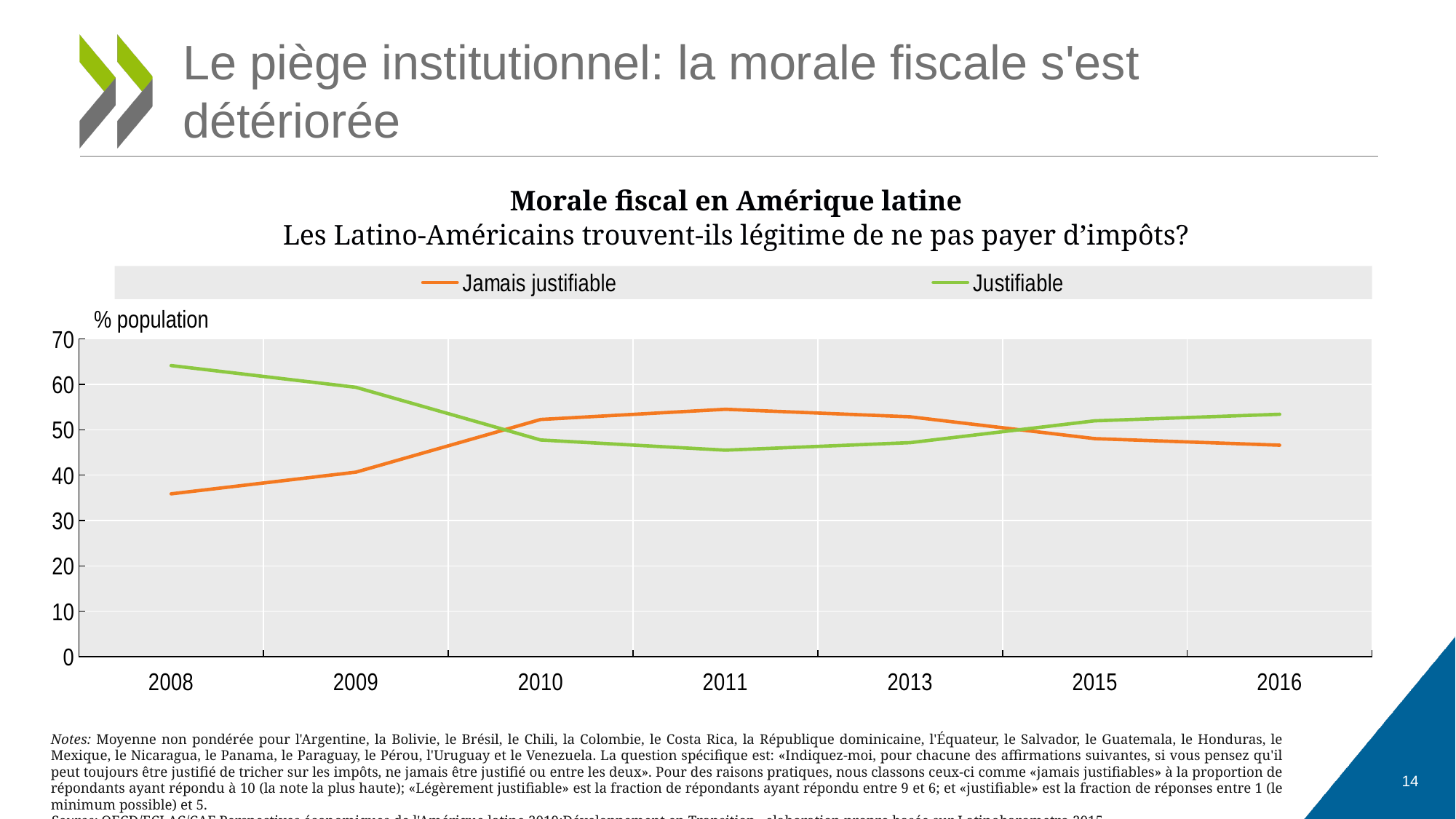
Is the value for Justifiable in 2011 greater or less than 50? less How many years are shown on the x axis? 7 How many series does the legend list? 2 In which year is the Justifiable series at its highest? 2008 In which year is the Jamais justifiable series at its lowest? 2008 Is the value for Jamais justifiable in 2011 greater or less than 50? greater Does the Jamais justifiable series rise or fall between 2008 and 2011? Rise What kind of chart is shown on the slide? Line chart In 2008, which series has the larger value, Jamais justifiable or Justifiable? Justifiable What unit is shown on the y axis label? % population Is the value for Justifiable in 2008 greater or less than 60? greater